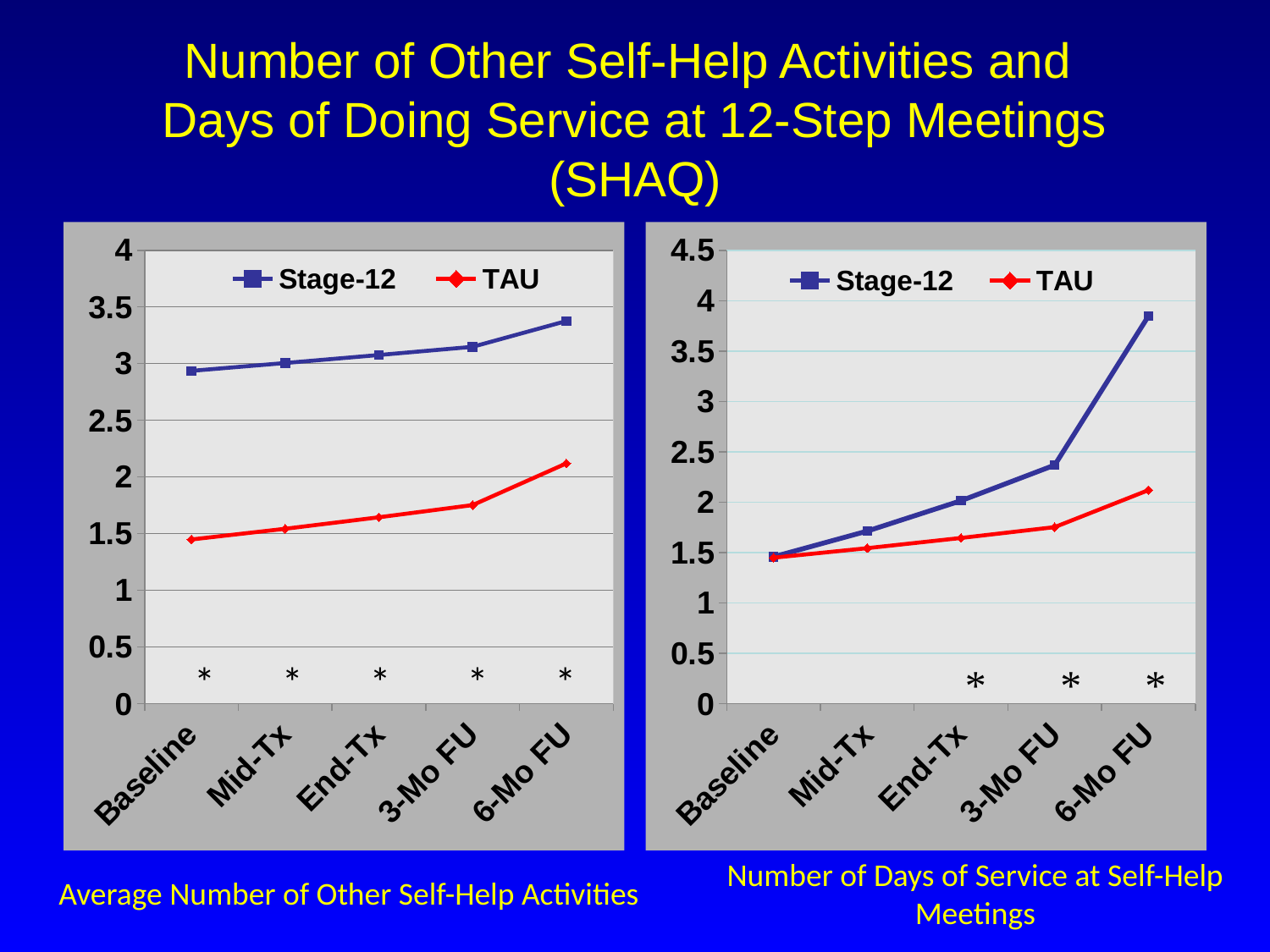
In the right chart, 'Number of Days of Service at Self-Help Meetings', is the Stage-12 value at 6-Mo FU greater or less than 3.5? greater In the left chart, 'Average Number of Other Self-Help Activities', which series is higher at Baseline, Stage-12 or TAU? Stage-12 In the right chart, 'Number of Days of Service at Self-Help Meetings', does the TAU line rise or fall from Baseline to 6-Mo FU? rise In the right chart, 'Number of Days of Service at Self-Help Meetings', which series is higher at 6-Mo FU, Stage-12 or TAU? Stage-12 What colour is the TAU line in the left chart, 'Average Number of Other Self-Help Activities'? red How many series does the legend list in the right chart, 'Number of Days of Service at Self-Help Meetings'? 2 In the left chart, 'Average Number of Other Self-Help Activities', is the TAU value at 3-Mo FU greater or less than 2? less What kind of chart is the left chart, 'Average Number of Other Self-Help Activities'? line chart In the right chart, 'Number of Days of Service at Self-Help Meetings', is the Stage-12 value at Mid-Tx greater or less than 1.5? greater How many time points are shown on the x axis of the left chart, 'Average Number of Other Self-Help Activities'? 5 In the left chart, 'Average Number of Other Self-Help Activities', does the Stage-12 line rise or fall from Baseline to 6-Mo FU? rise